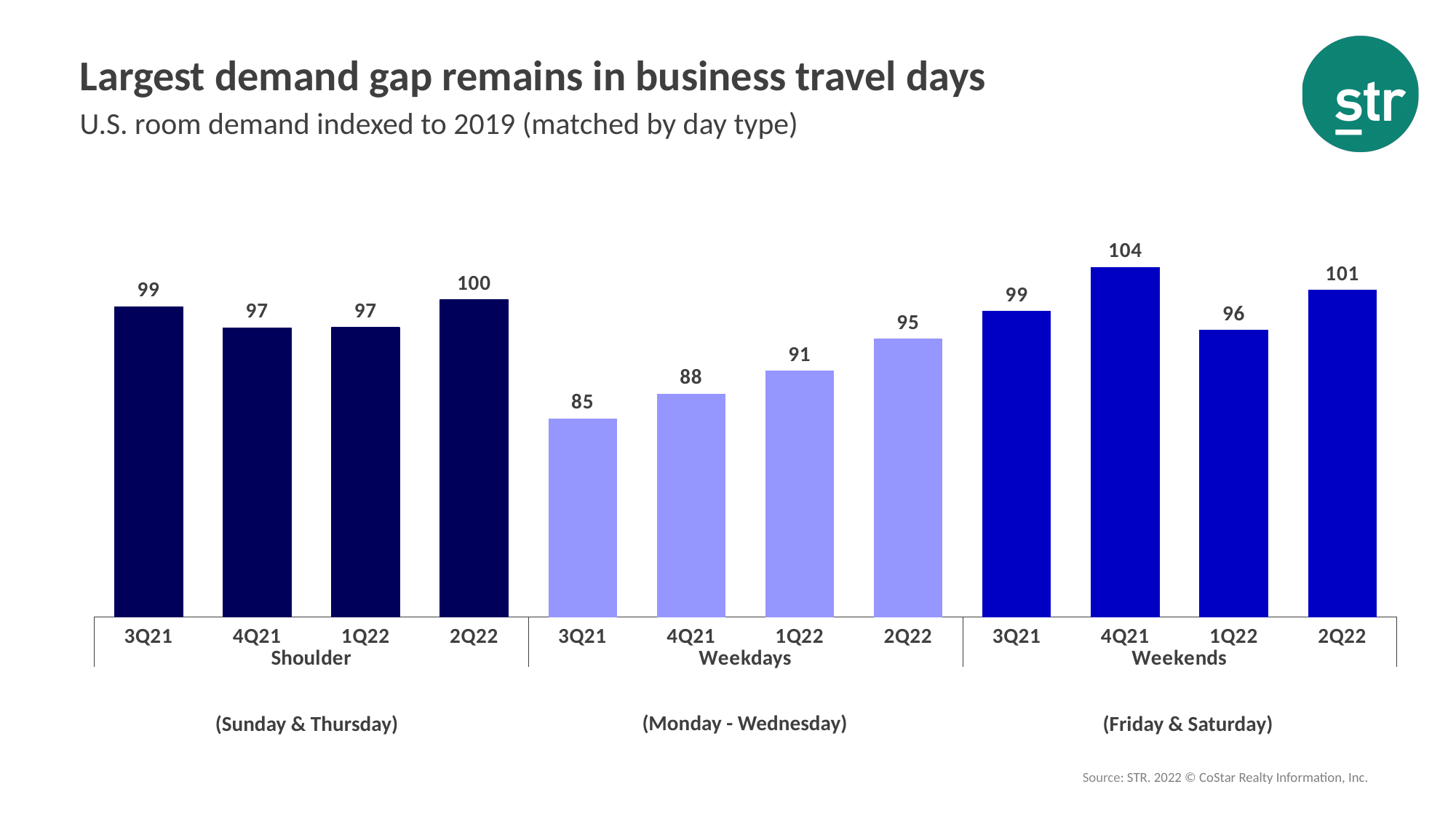
What is the indexed room demand for Weekdays in 3Q21? 85 What is the indexed room demand for Shoulder days in 2Q22? 100 Which days are included in the Shoulder day type? Sunday & Thursday Do the Weekdays values rise or fall from 3Q21 to 2Q22? Rise Which bar has the highest value on the chart? Weekends 4Q21 Which is larger, the Shoulder 3Q21 value or the Weekends 1Q22 value? Shoulder 3Q21 What is the title of the chart? Largest demand gap remains in business travel days What is the indexed room demand for Weekends in 4Q21? 104 What is the difference between the Weekends 2Q22 value and the Weekdays 2Q22 value? 6 Which bar has the lowest value on the chart? Weekdays 3Q21 What kind of chart is shown on the slide? Bar chart How many bars are plotted on the chart? 12